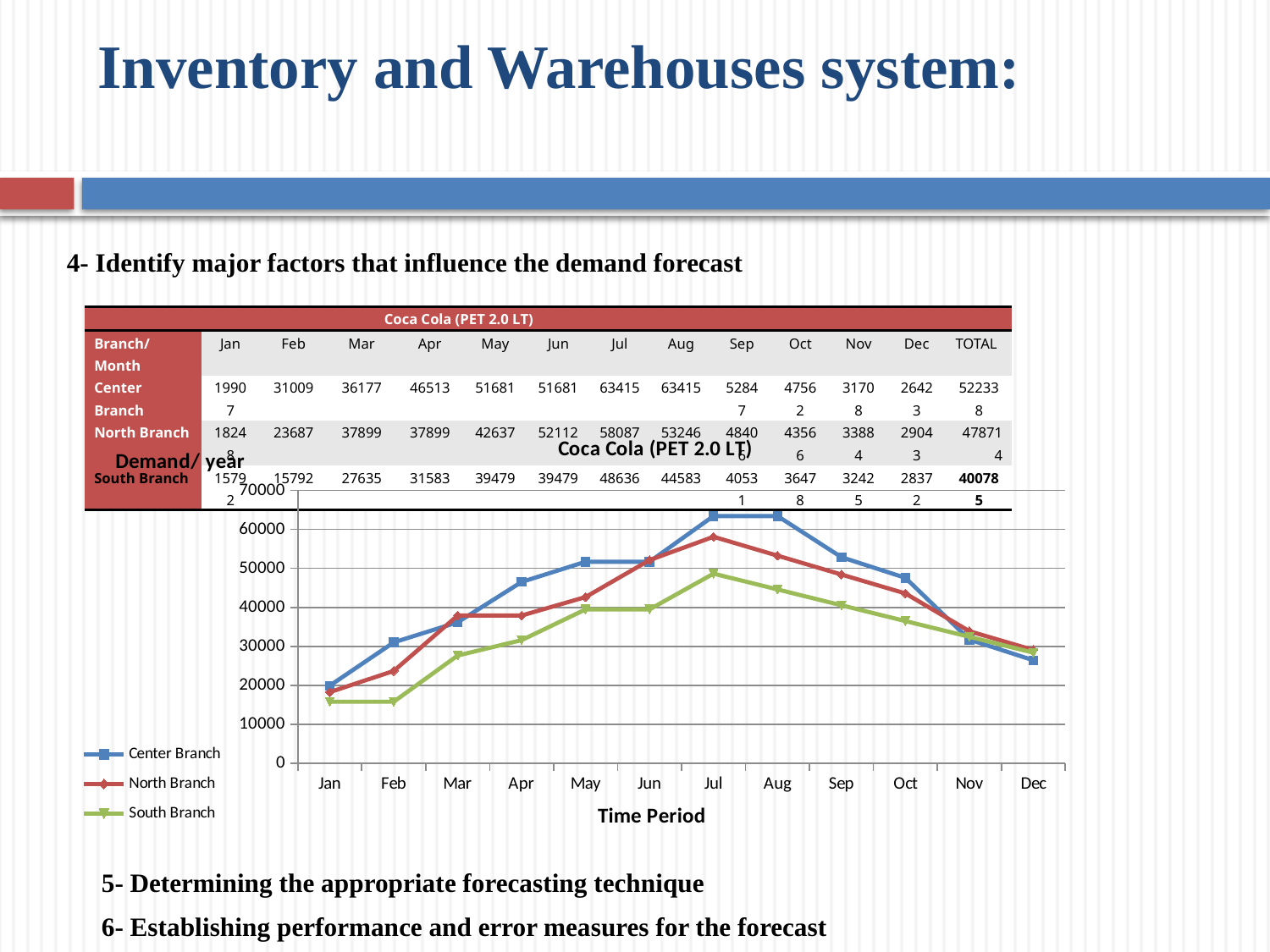
Which branch has the lowest value in Feb? South Branch Is the value for South Branch in Jan greater or less than 20000? less What kind of chart is shown on the slide? line chart How many series does the legend of the chart list? 3 In May, which is larger: Center Branch or South Branch? Center Branch How many months are plotted along the x axis of the chart? 12 What is the title of the chart? Coca Cola (PET 2.0 LT) Do the Center Branch values rise or fall from Aug to Dec? fall Which branch has the highest value in Jul? Center Branch Do the South Branch values rise or fall from Jan to Jul? rise Is the value for North Branch in Oct greater or less than 40000? greater Is the value for Center Branch in Jul greater or less than 60000? greater